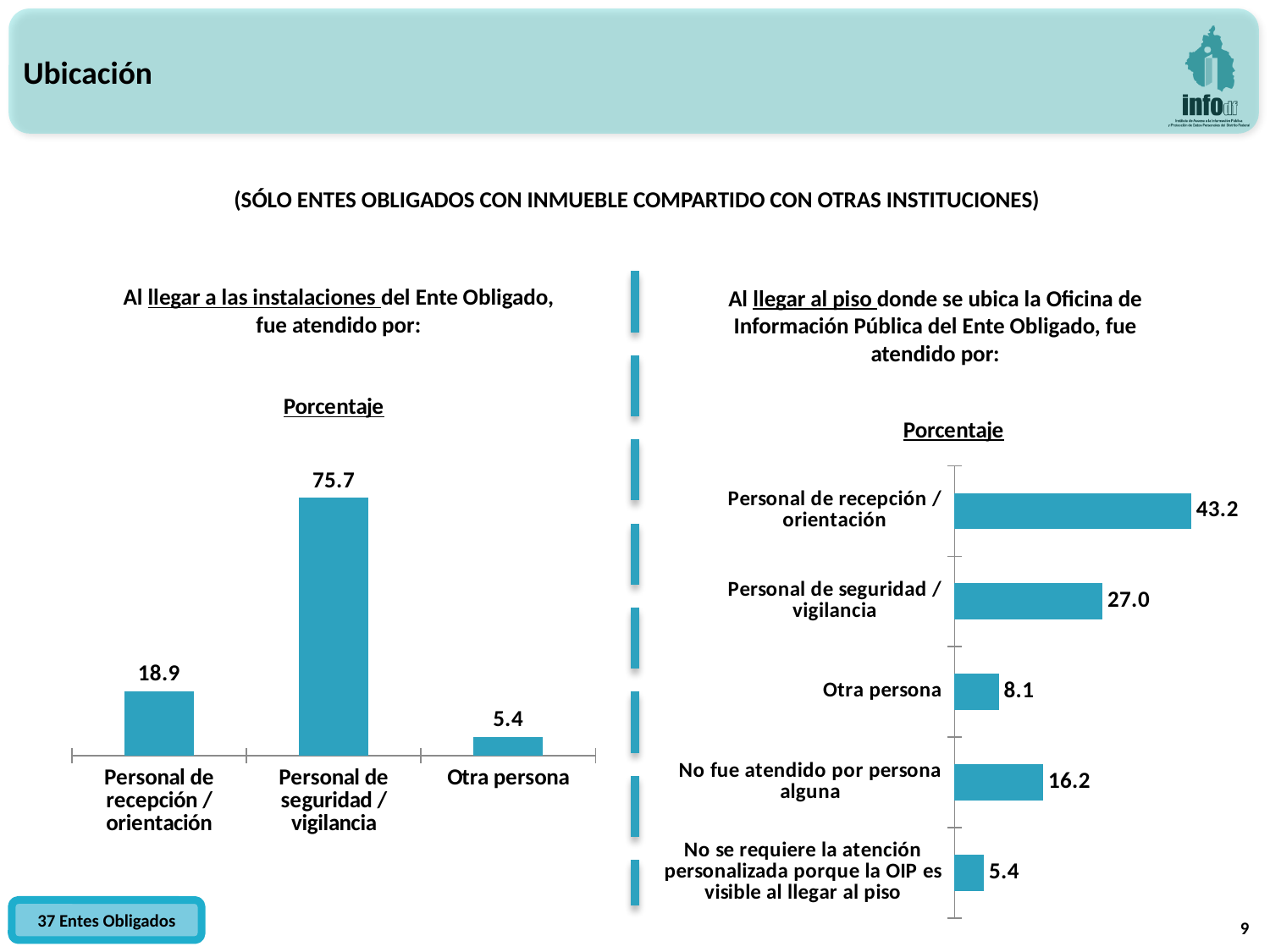
In the right chart (Al llegar al piso donde se ubica la Oficina de Información Pública), what is the value for Personal de recepción / orientación? 43.2 In the right chart (Al llegar al piso donde se ubica la Oficina de Información Pública), what is the difference between Personal de recepción / orientación and Personal de seguridad / vigilancia? 16.2 In the right chart (Al llegar al piso donde se ubica la Oficina de Información Pública), which is larger: Otra persona or No fue atendido por persona alguna? No fue atendido por persona alguna How many categories are shown in the left chart (Al llegar a las instalaciones del Ente Obligado)? 3 In the left chart (Al llegar a las instalaciones del Ente Obligado), what is the value for Personal de recepción / orientación? 18.9 In the right chart (Al llegar al piso donde se ubica la Oficina de Información Pública), what is the value for No fue atendido por persona alguna? 16.2 In the right chart (Al llegar al piso donde se ubica la Oficina de Información Pública), which category has the highest value? Personal de recepción / orientación In the left chart (Al llegar a las instalaciones del Ente Obligado), what is the value for Personal de seguridad / vigilancia? 75.7 In the left chart (Al llegar a las instalaciones del Ente Obligado), what is the difference between Personal de seguridad / vigilancia and Personal de recepción / orientación? 56.8 What type of chart is the left chart (Al llegar a las instalaciones del Ente Obligado)? Bar chart In the left chart (Al llegar a las instalaciones del Ente Obligado), which category has the lowest value? Otra persona How many categories are shown in the right chart (Al llegar al piso donde se ubica la Oficina de Información Pública)? 5